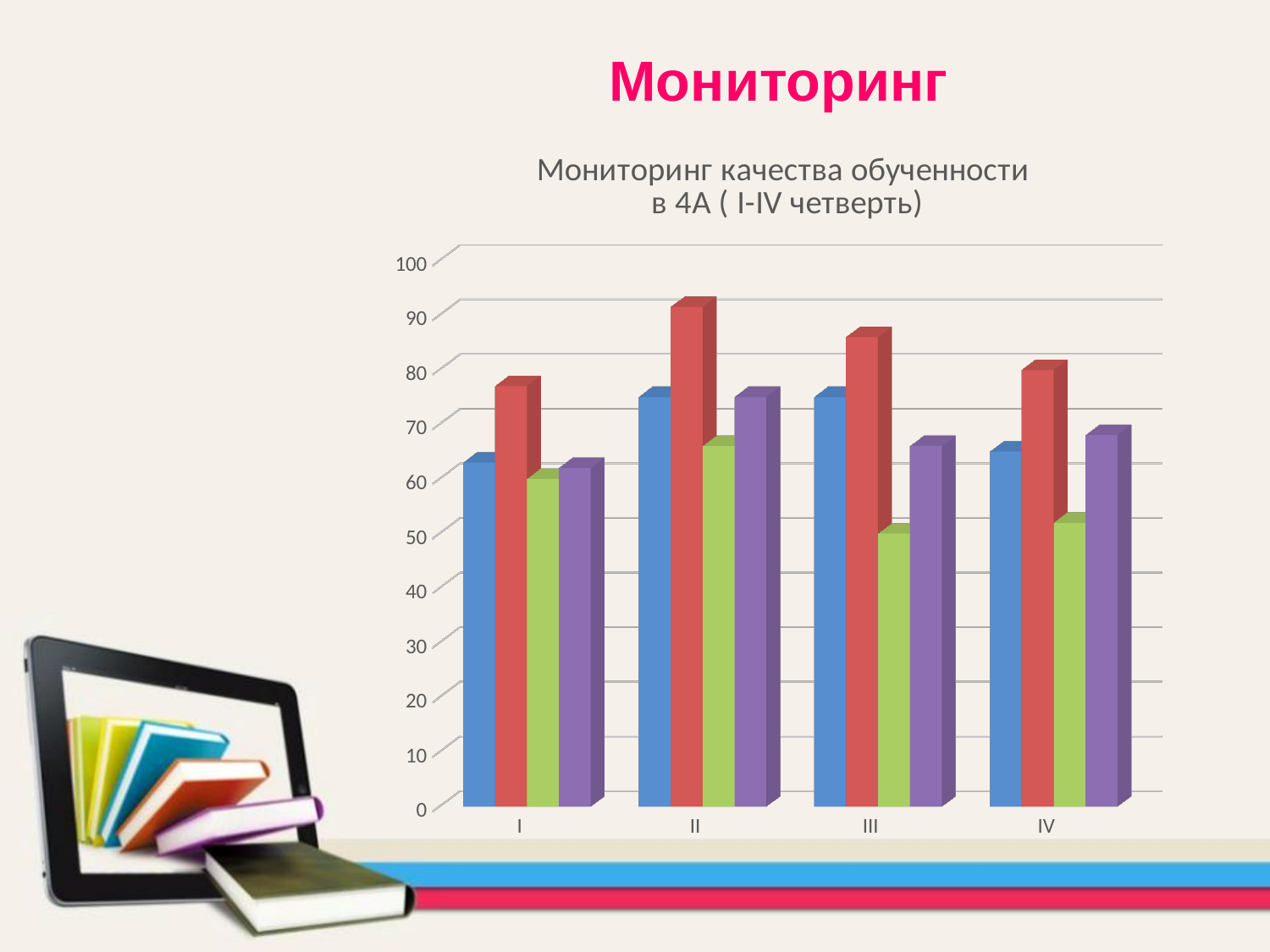
Is the value of the blue bar for category I greater or less than 70? less Is the value of the red bar for category II greater or less than 80? greater What is the title of the chart? Мониторинг качества обученности в 4А ( I-IV четверть) How many categories are shown on the x axis of the chart? 4 In category I, which bar is taller, the red bar or the blue bar? red In which category is the red bar the tallest? II How many bars are plotted for each category on the chart? 4 What kind of chart is shown on the slide? bar chart Is the value of the green bar for category III greater or less than 60? less In which category is the green bar the tallest? II